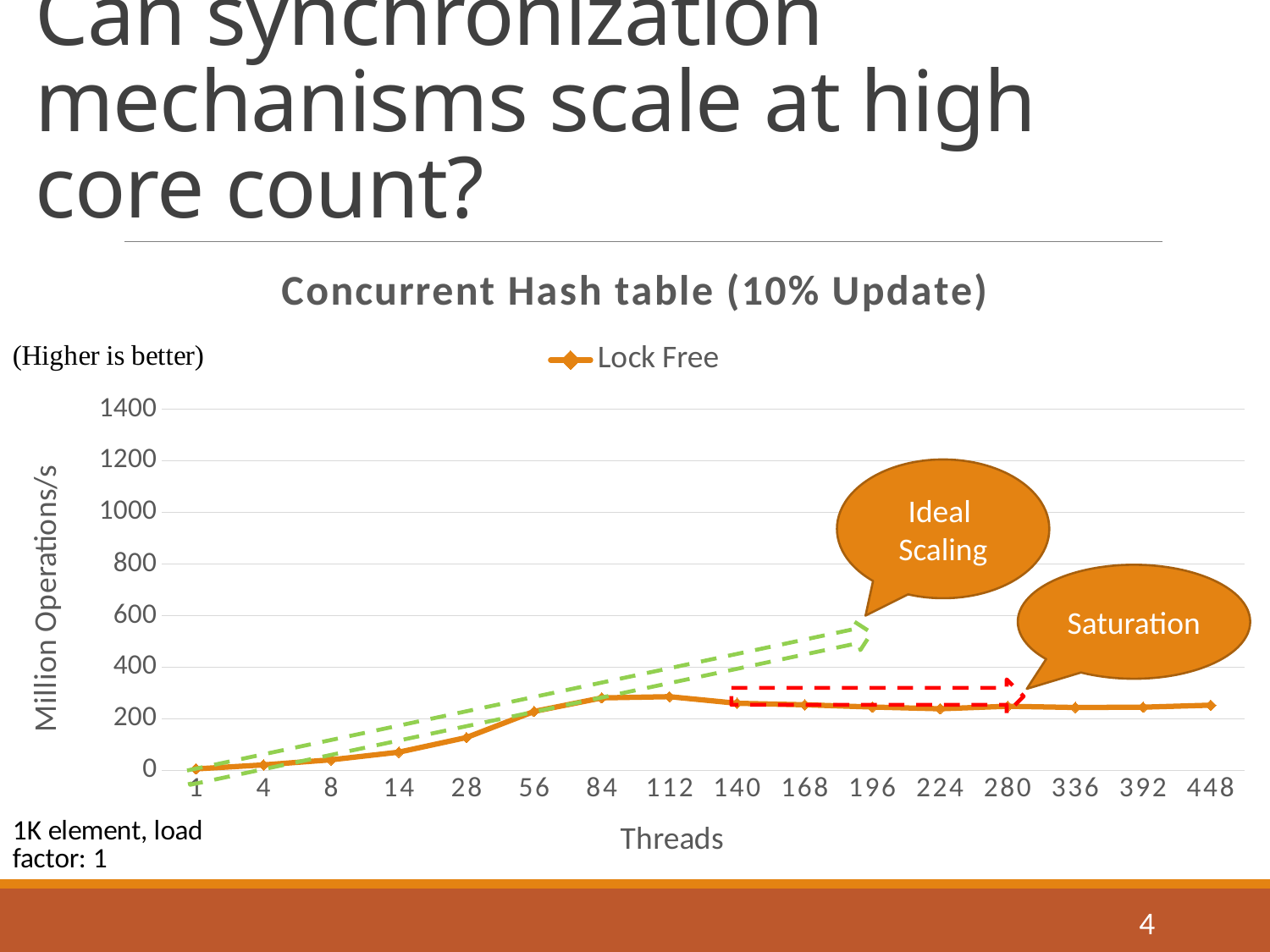
Which has the larger Lock Free value, 14 threads or 56 threads? 56 threads Is the Lock Free value at 448 threads greater or less than 200? greater Is the Lock Free value at 112 threads greater or less than 400? less How many series does the legend list? 1 Is the Lock Free value at 28 threads greater or less than 200? less Which thread count has the lowest Lock Free value? 1 What is the title of the chart? Concurrent Hash table (10% Update) What is the label of the y axis? Million Operations/s How many thread counts are plotted along the x axis? 16 Does the Lock Free line rise or fall from 1 thread to 84 threads? rise What kind of chart is shown on the slide? Line chart